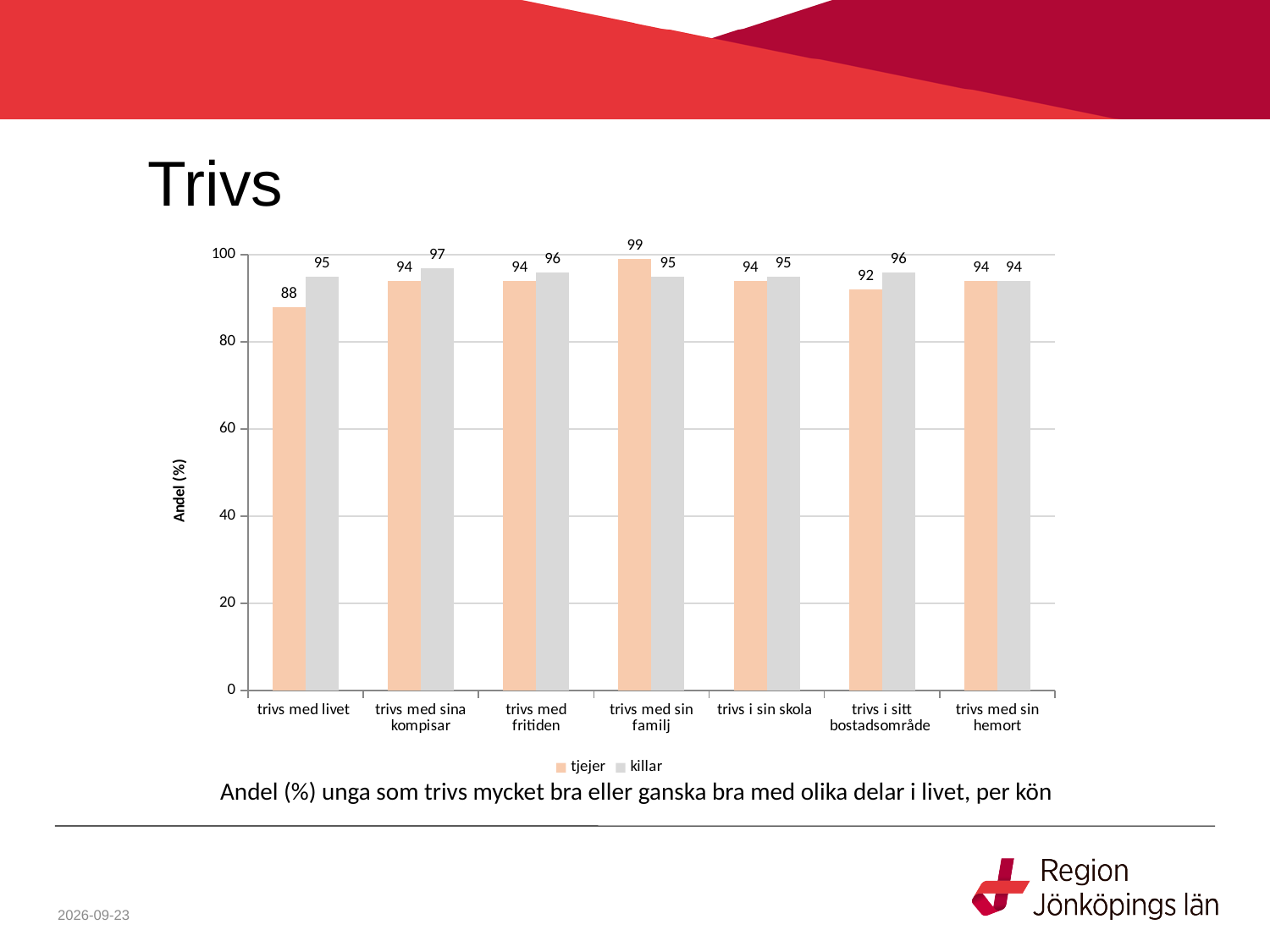
What is the value for tjejer in the 'trivs med livet' category? 88 How many series does the legend list? 2 Is the value for tjejer in 'trivs med livet' greater or less than 80? greater What is the value for tjejer in the 'trivs med sin familj' category? 99 What is the label of the y axis? Andel (%) What is the value for killar in the 'trivs med sina kompisar' category? 97 What kind of chart is shown on the slide? bar chart Which category has the highest value for tjejer? trivs med sin familj Which category has the lowest value for tjejer? trivs med livet How many categories are shown on the x axis? 7 In the 'trivs med sin familj' category, which is larger, tjejer or killar? tjejer What is the difference between killar and tjejer in the 'trivs med livet' category? 7